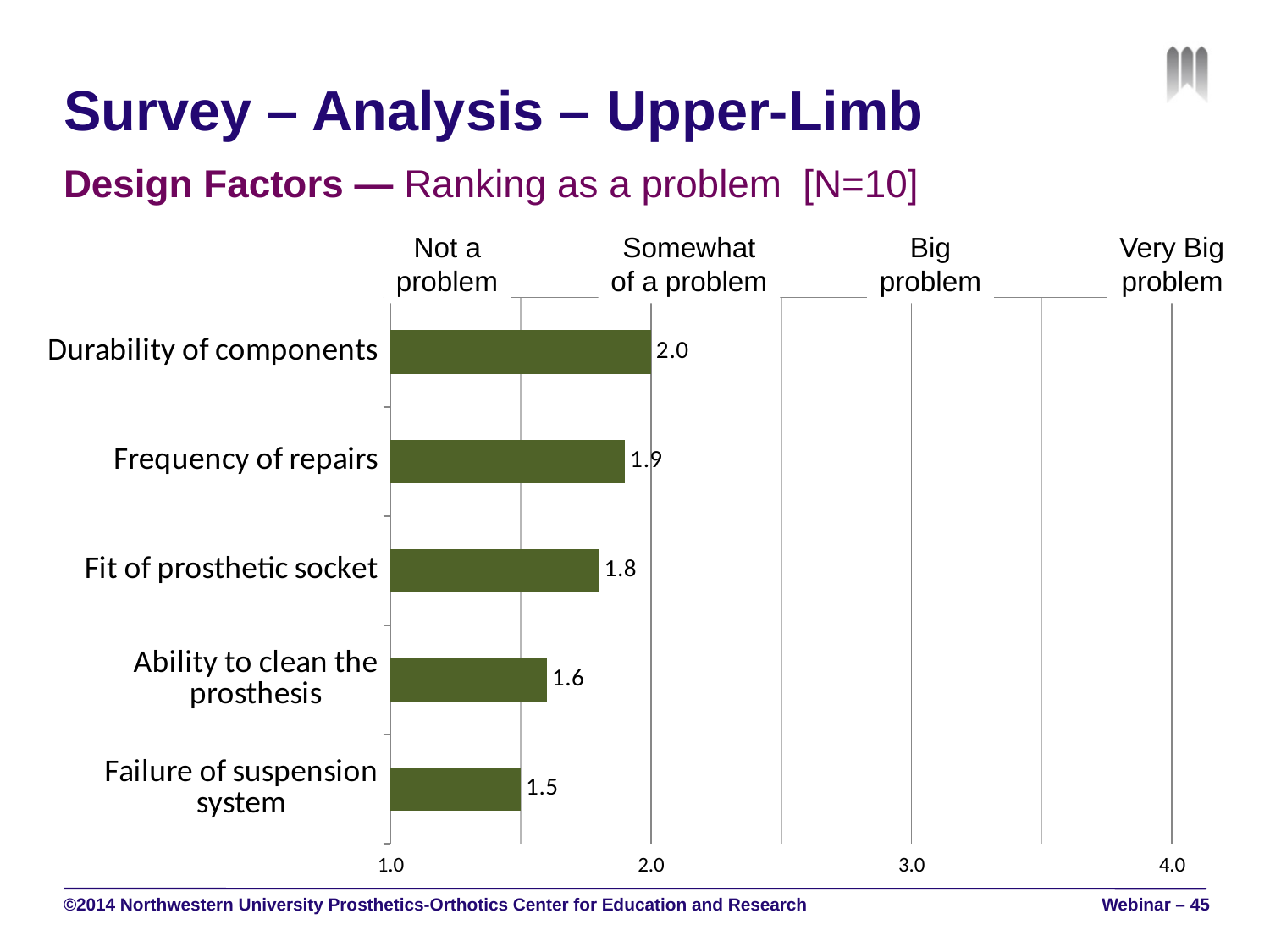
Which is larger, the value for Fit of prosthetic socket or the value for Ability to clean the prosthesis? Fit of prosthetic socket What is the value for Ability to clean the prosthesis? 1.6 Which design factor has the lowest ranking as a problem? Failure of suspension system What is the value for Failure of suspension system? 1.5 What is the value for Frequency of repairs? 1.9 What label on the x axis corresponds to the value 3.0? Big problem What kind of chart is shown on the slide? Bar chart How many design factors are shown in the chart? 5 What is the value for Durability of components? 2.0 What is the difference between the values for Durability of components and Failure of suspension system? 0.5 What is the value for Fit of prosthetic socket? 1.8 Which design factor has the highest ranking as a problem? Durability of components